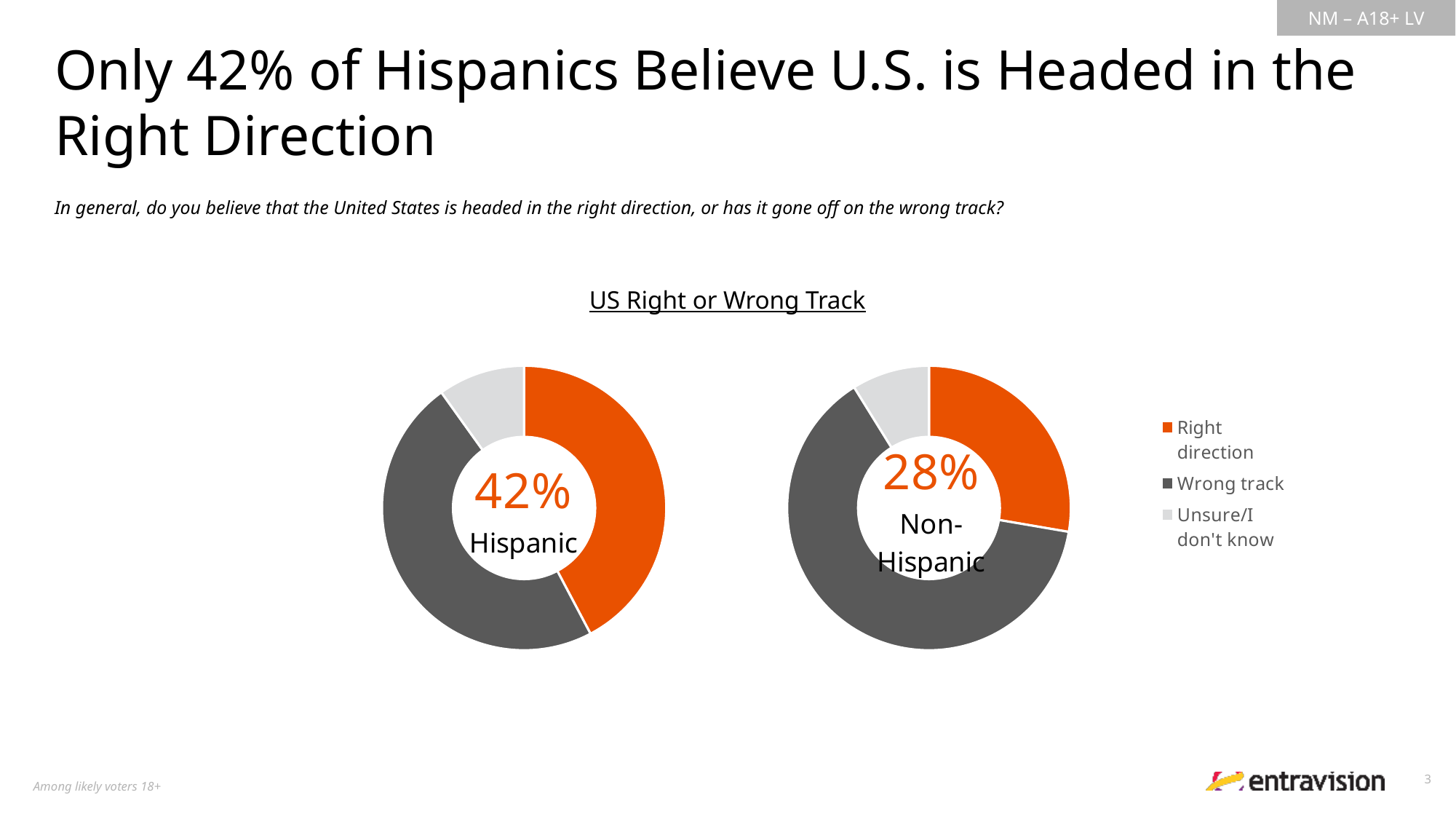
In the Hispanic donut chart, what share of respondents say the U.S. is headed in the right direction? 42% In the Hispanic donut chart, which response category takes up the smallest slice? Unsure/I don't know How many categories does the legend list for the charts? 3 In the Non-Hispanic donut chart, what share of respondents say the U.S. is headed in the right direction? 28% How many slices does each donut chart have? 3 What kind of charts are shown on the slide? Donut (pie) charts How many percentage points higher is the Hispanic 'Right direction' share than the Non-Hispanic 'Right direction' share? 14 percentage points What is the title shown above the two donut charts? US Right or Wrong Track Which colour represents 'Right direction' in the charts? Orange Which group has the larger share saying the U.S. is headed in the right direction, Hispanic or Non-Hispanic? Hispanic In the Hispanic donut chart, which response category takes up the largest slice? Wrong track In the Non-Hispanic donut chart, which response category takes up the largest slice? Wrong track